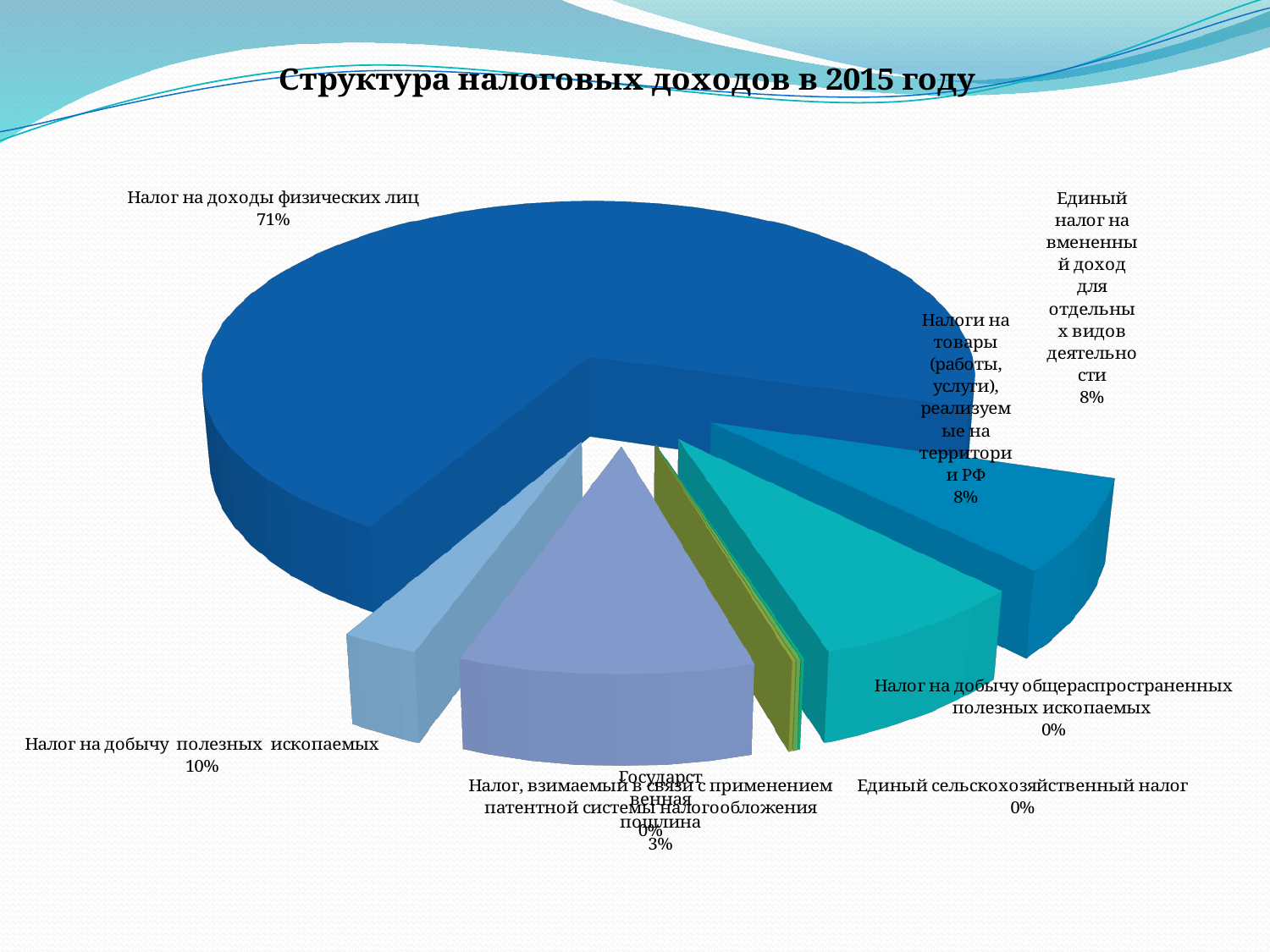
What type of chart is shown on the slide? Pie chart What percentage is shown for "Единый сельскохозяйственный налог"? 0% Which is larger: the share for "Налог на добычу полезных ископаемых" or for "Налоги на товары (работы, услуги), реализуемые на территории РФ"? Налог на добычу полезных ископаемых What share of the pie does "Налоги на товары (работы, услуги), реализуемые на территории РФ" represent? 8% What share of tax revenues does "Налог на доходы физических лиц" account for? 71% Which category has the largest share of tax revenues? Налог на доходы физических лиц What share is shown for "Налог на добычу полезных ископаемых"? 10% What is the title of the chart? Структура налоговых доходов в 2015 году How many categories (slices) does the pie chart have? 8 What is the difference in percentage points between "Налог на доходы физических лиц" and "Налог на добычу полезных ископаемых"? 61 percentage points What share is shown for "Налог, взимаемый в связи с применением патентной системы налогообложения"? 0% What percentage is shown for "Единый налог на вмененный доход для отдельных видов деятельности"? 8%